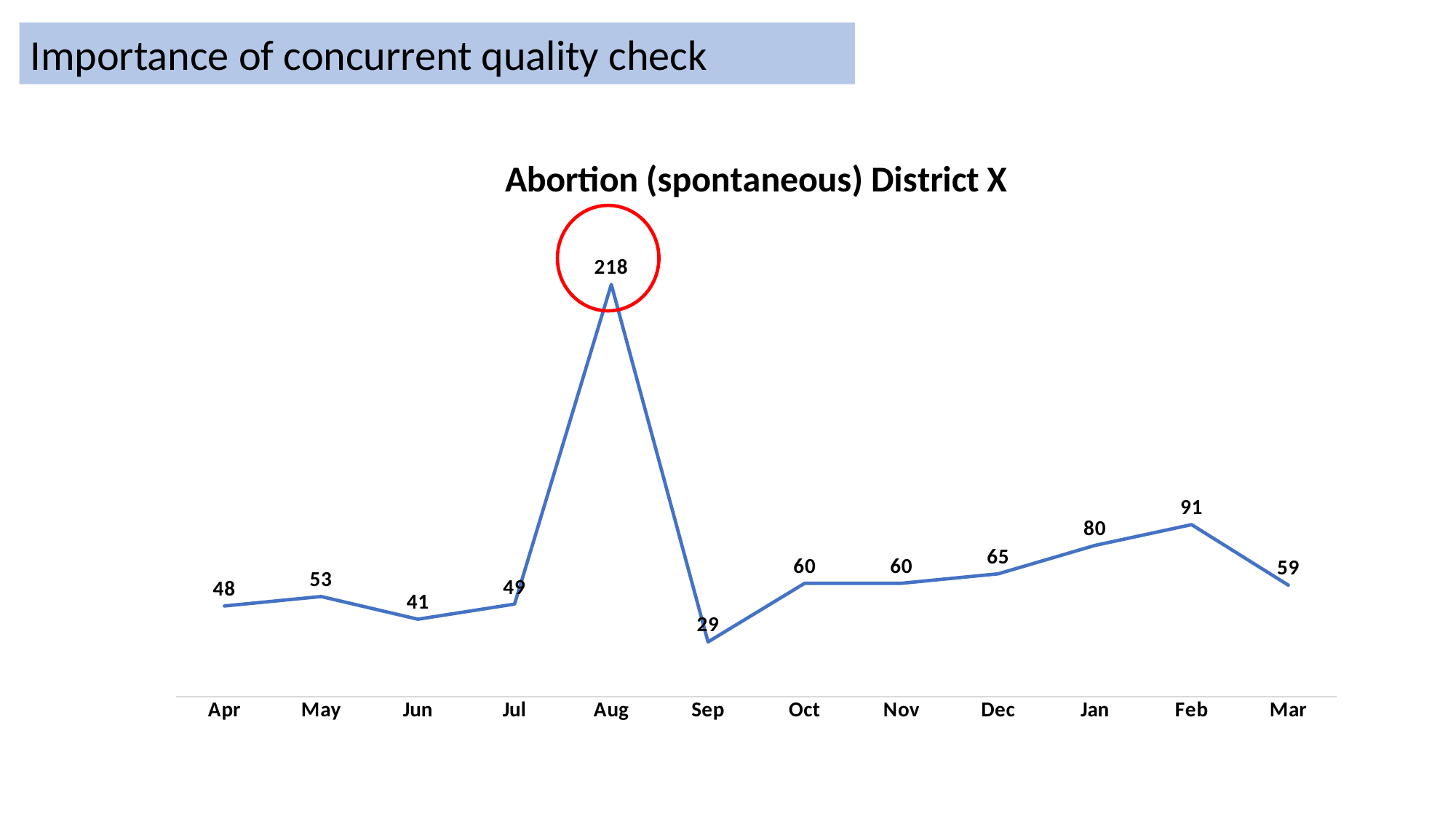
What is the value for Sep? 29 What kind of chart is shown? Line chart What is the difference between the values for Aug and Jul? 169 Which month has the highest value? Aug Which month has the lowest value? Sep How many months are plotted on the x axis? 12 Do the values rise or fall from Oct to Feb? Rise What is the title of the chart? Abortion (spontaneous) District X What is the value for Feb? 91 What is the difference between the values for Feb and Mar? 32 What is the value for Aug? 218 Which is larger, the value for Jan or the value for Dec? Jan